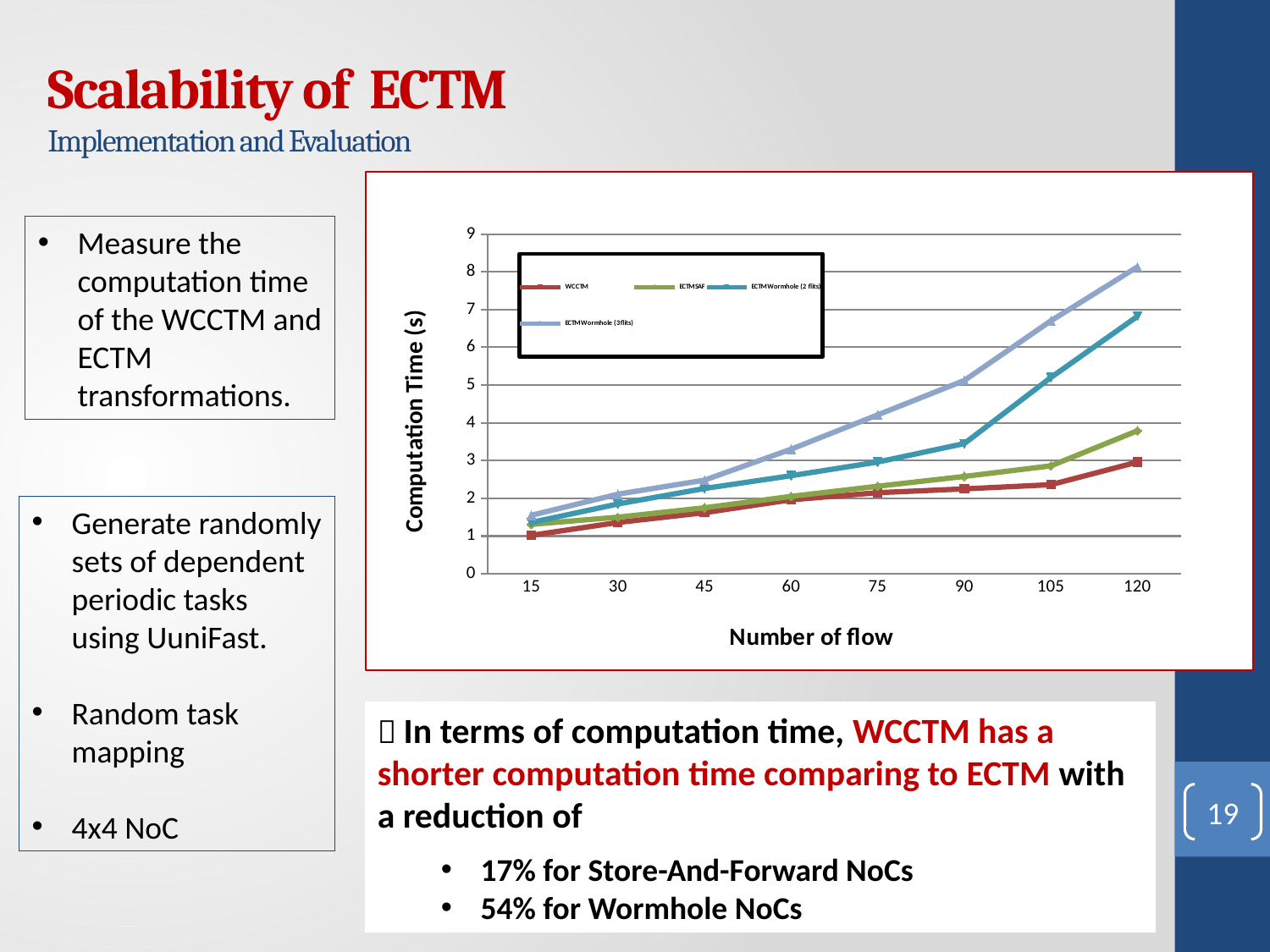
What kind of chart is shown on the slide? line chart At 60 flows, which has the larger computation time: ECTM Wormhole (3 flits) or ECTM Wormhole (2 flits)? ECTM Wormhole (3 flits) Is the computation time for WCCTM at 120 flows greater or less than 4? less Is the computation time for ECTM Wormhole (2 flits) at 90 flows greater or less than 3? greater Which series has the lowest computation time at 120 flows? WCCTM What is the title of the chart's y axis? Computation Time (s) How many series does the chart's legend list? 4 Is the computation time for ECTM Wormhole (3 flits) at 120 flows greater or less than 7? greater How many values of Number of flow are plotted along the x axis? 8 Does the computation time for WCCTM rise or fall as the number of flows increases from 15 to 120? rise Which series has the highest computation time at 120 flows? ECTM Wormhole (3 flits)